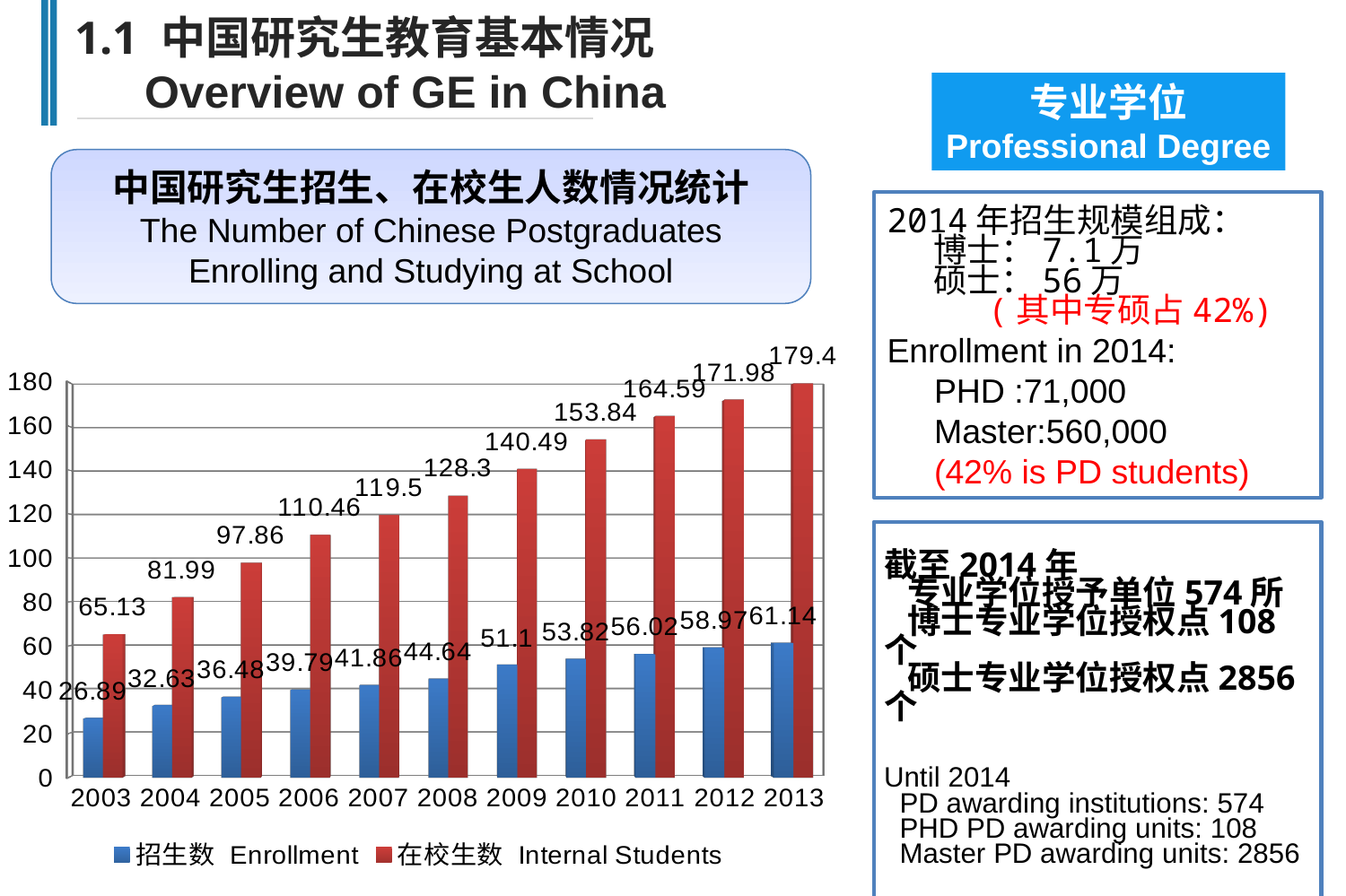
How many years are shown on the x axis of the chart? 11 Do the Internal Students values rise or fall from 2003 to 2013? Rise What is the Enrollment value for 2003? 26.89 What kind of chart is shown on the slide? Bar chart Which is larger in 2009: Enrollment or Internal Students? Internal Students How many series does the chart legend list? 2 What is the difference between the Internal Students values for 2013 and 2012? 7.42 What is the Internal Students value for 2008? 128.3 Which year has the highest Internal Students value? 2013 What is the value of Internal Students in 2013? 179.4 What is the Enrollment value for 2010? 53.82 Which year has the lowest Enrollment value? 2003